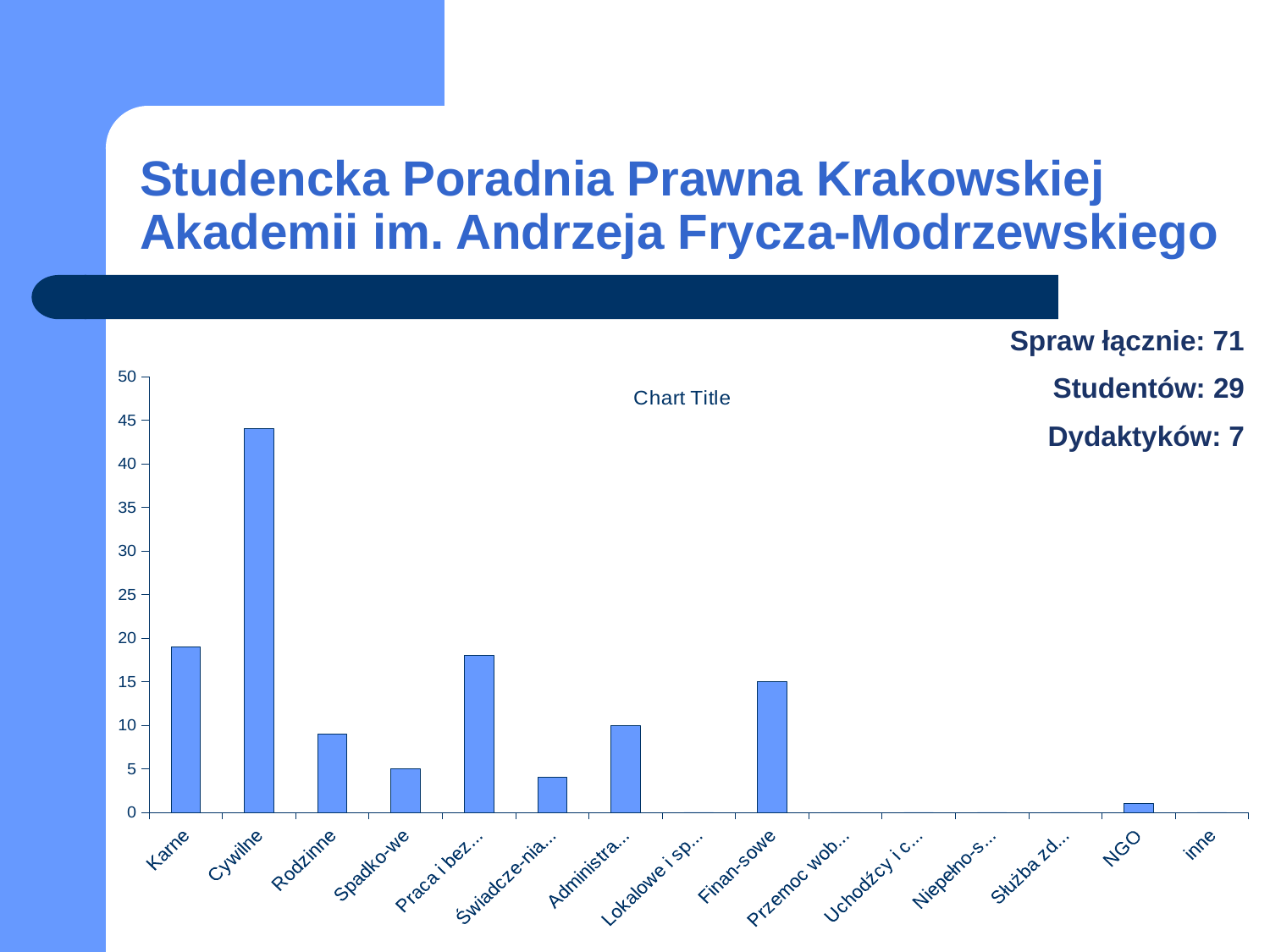
What is the value for Administra...? 10 Is the value for Rodzinne greater or less than 10? less Which is larger, the value for Karne or the value for Rodzinne? Karne What is the value for Spadko-we? 5 What is the difference between the values for Finan-sowe and Administra...? 5 What is the value for Finan-sowe? 15 What type of chart is shown on the slide? bar chart What is the title shown on the chart? Chart Title Is the value for Cywilne greater or less than 40? greater Which category has the highest value in the chart? Cywilne How many categories are shown on the x axis of the chart? 15 Is the value for Karne greater or less than 15? greater